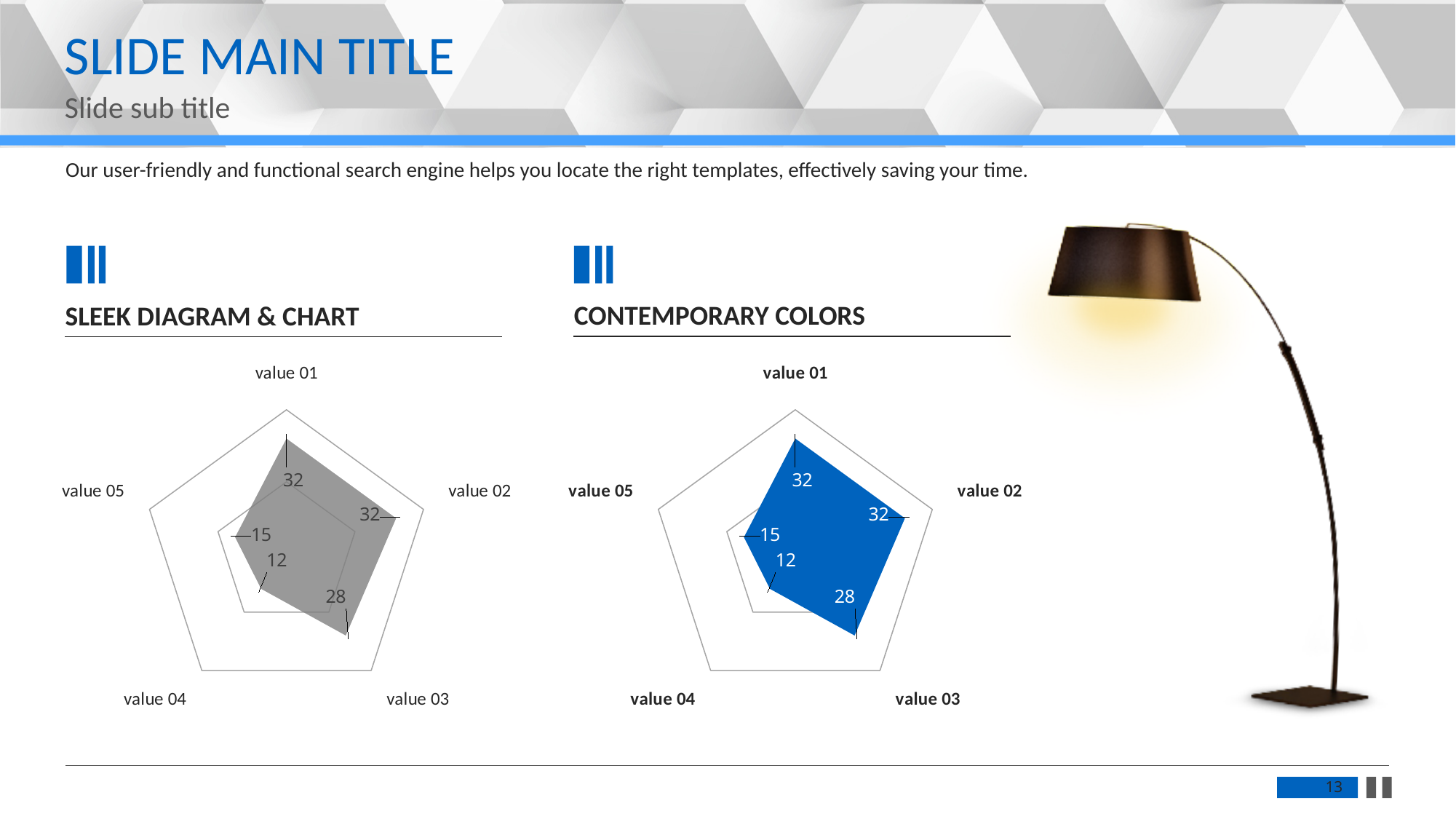
In the left chart, what is the value for value 03? 28 In the left chart, what is the value for value 04? 12 In the right chart, what is the value for value 05? 15 In the right chart, what is the value for value 02? 32 How many categories are plotted in the right chart? 5 In the right chart, which is larger, value 03 or value 05? value 03 What colour is the data area in the right chart? blue In the left chart, which category has the lowest value? value 04 What colour is the data area in the left chart? gray What type of chart is shown on the left side of the slide? radar chart In the right chart, what is the difference between value 03 and value 04? 16 In the left chart, what is the difference between value 01 and value 05? 17